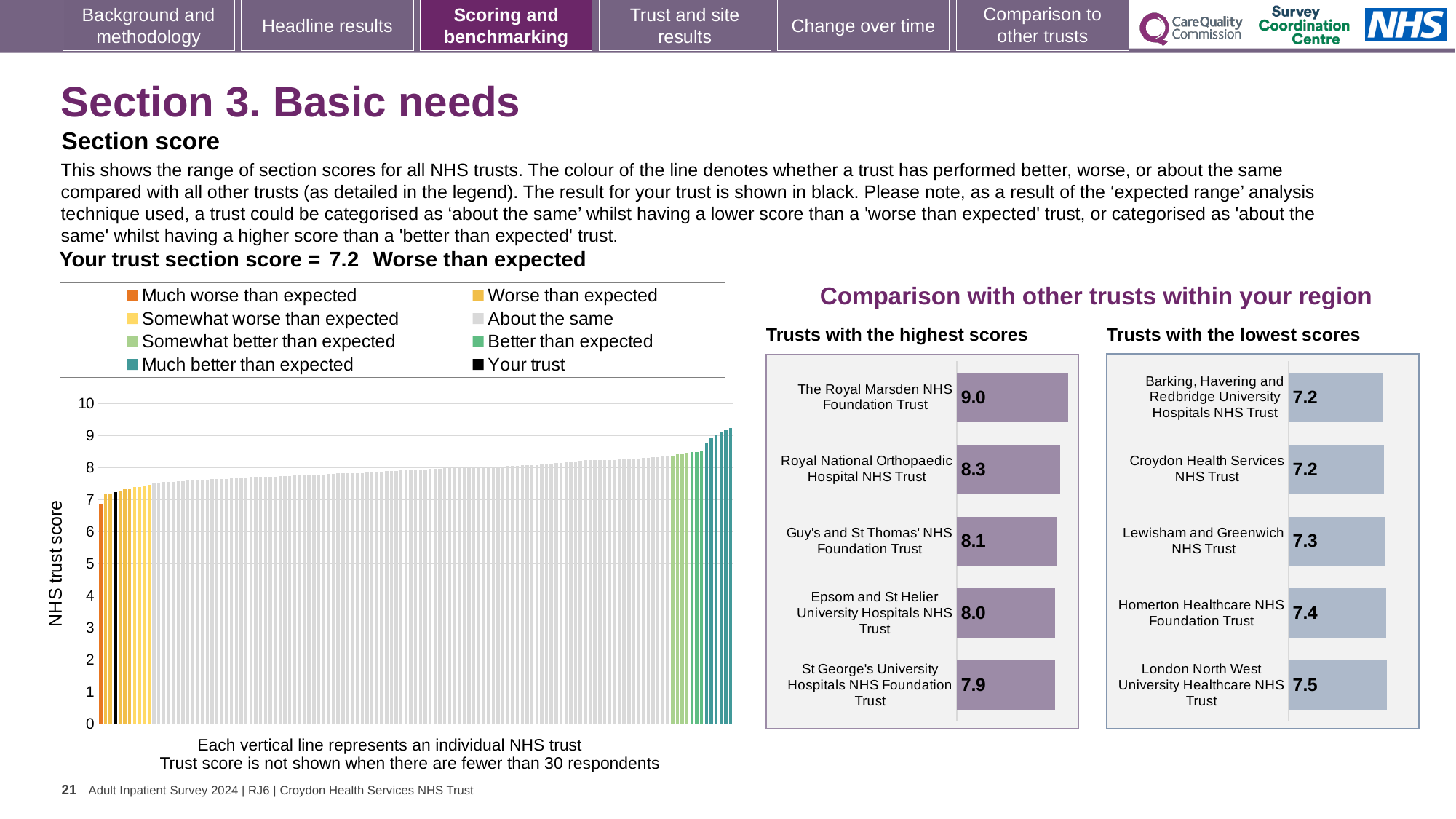
In the 'Trusts with the lowest scores' chart, what is the difference between the scores of London North West University Healthcare NHS Trust and Croydon Health Services NHS Trust? 0.3 In the 'Trusts with the lowest scores' chart, what is the score for Homerton Healthcare NHS Foundation Trust? 7.4 In the 'Trusts with the highest scores' chart, what is the score for The Royal Marsden NHS Foundation Trust? 9.0 In the 'Trusts with the highest scores' chart, what is the score for St George's University Hospitals NHS Foundation Trust? 7.9 How many entries does the legend of the main 'NHS trust score' chart list? 8 In the main 'NHS trust score' chart, is the value of the tallest bar greater or less than 9? greater What kind of chart is the main chart on the left showing NHS trust scores? Bar chart In the 'Trusts with the highest scores' chart, what is the difference between the scores of The Royal Marsden NHS Foundation Trust and Royal National Orthopaedic Hospital NHS Trust? 0.7 In the 'Trusts with the lowest scores' chart, which trust has the highest score? London North West University Healthcare NHS Trust In the 'Trusts with the highest scores' chart, which trust has the lowest score? St George's University Hospitals NHS Foundation Trust How many trusts are shown in the 'Trusts with the lowest scores' chart? 5 In the 'Trusts with the highest scores' chart, which has the higher score: Guy's and St Thomas' NHS Foundation Trust or Epsom and St Helier University Hospitals NHS Trust? Guy's and St Thomas' NHS Foundation Trust